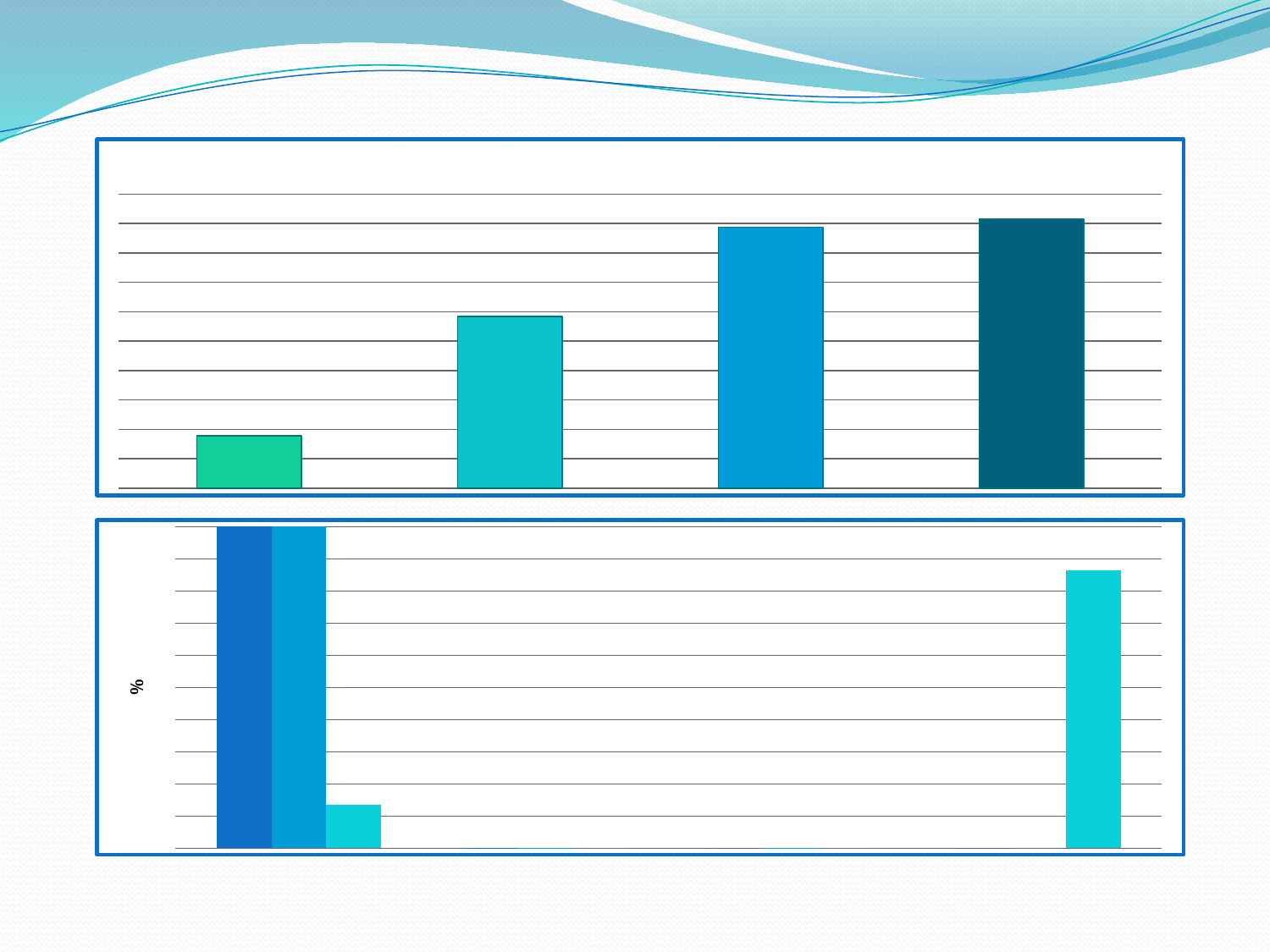
What kind of chart is the top chart on the slide? Bar chart In the top chart, how many bars are plotted? 4 What label is shown on the vertical axis of the bottom chart? % In the top chart, which is taller, the leftmost bar or the second bar from the left? The second bar from the left In the top chart, which bar is the tallest? The rightmost bar In the top chart, which bar is the shortest? The leftmost bar In the bottom chart, which is taller, the leftmost bar or the rightmost bar? The leftmost bar In the top chart, what colour is the leftmost bar? Green In the top chart, do the bar values rise or fall from left to right? Rise What kind of chart is the bottom chart on the slide? Bar chart